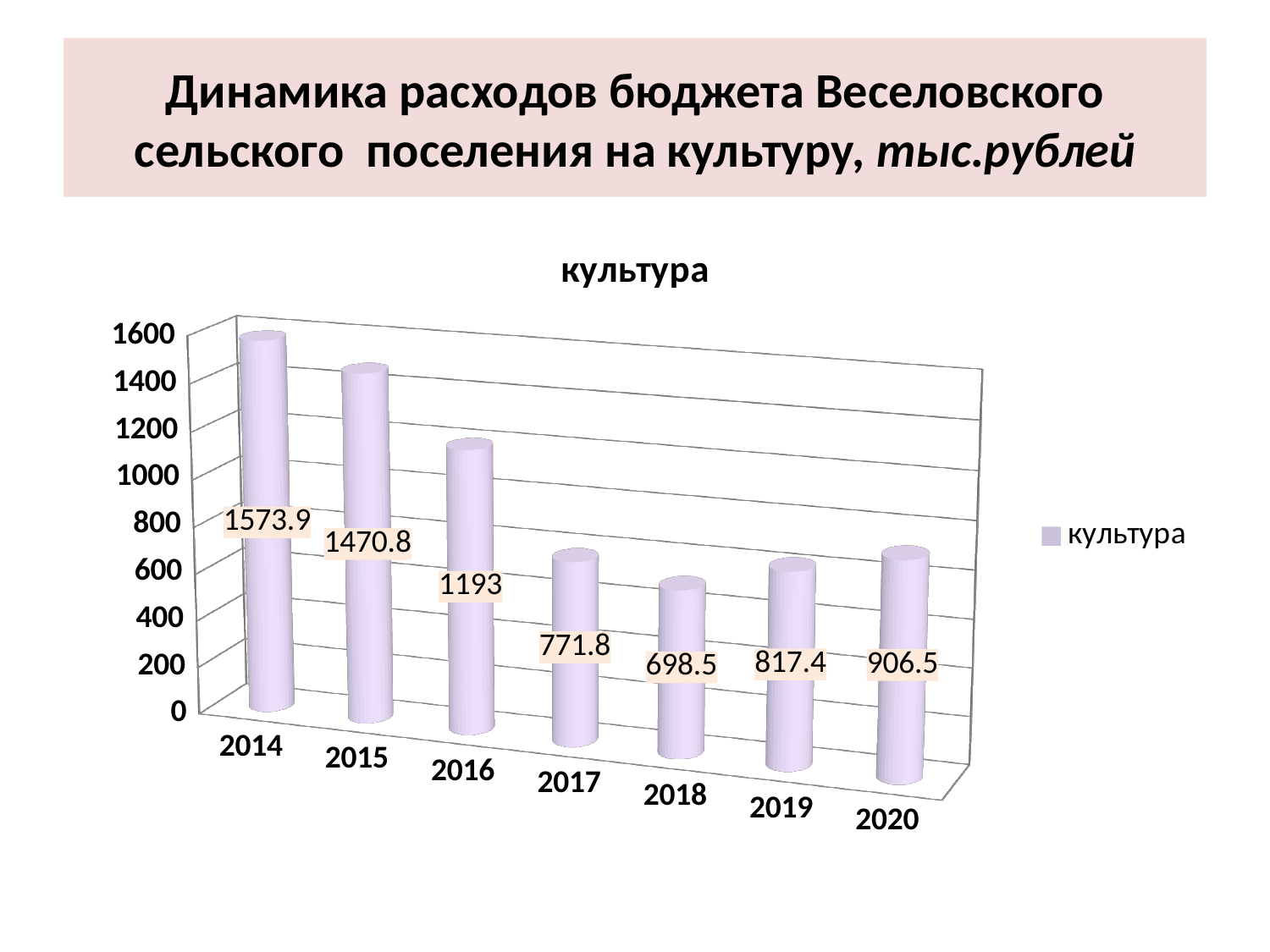
What is the value for 2018? 698.5 What kind of chart is this? bar chart Which is larger, the value for 2016 or the value for 2017? 2016 What is the difference between the values for 2020 and 2019? 89.1 Which year has the highest value? 2014 What is the chart's title? культура What is the value for 2020? 906.5 What is the difference between the values for 2014 and 2015? 103.1 Which year has the lowest value? 2018 What is the value for 2014? 1573.9 How many years are shown on the x axis? 7 Is the value for 2019 greater or less than 1000? less